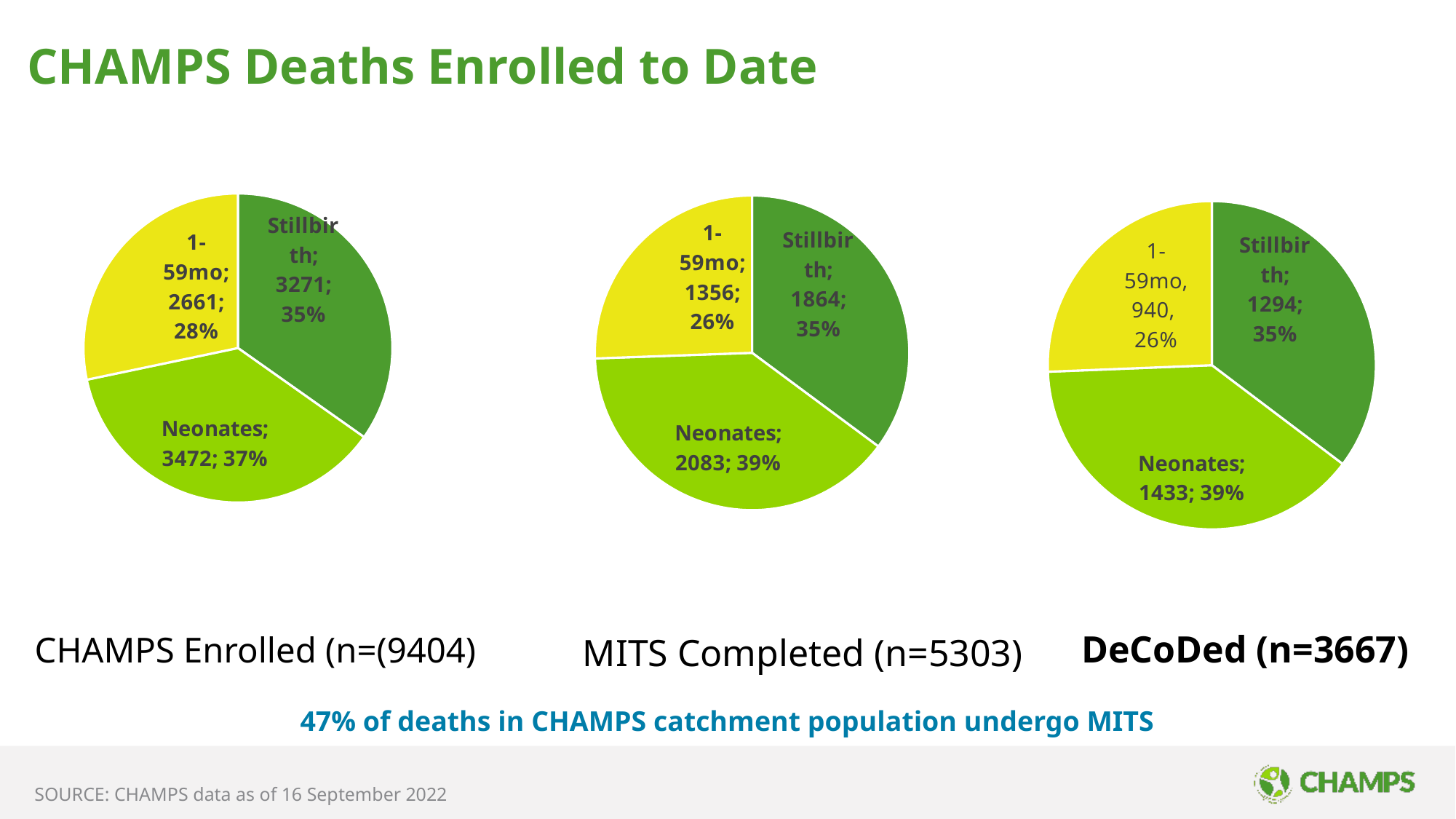
In the MITS Completed pie chart, what percentage share do Neonates have? 39% In the MITS Completed pie chart, what is the difference between the Stillbirth value and the 1-59mo value? 508 In the CHAMPS Enrolled pie chart, which is larger: Stillbirth or 1-59mo? Stillbirth In the CHAMPS Enrolled pie chart, what percentage share does 1-59mo have? 28% In the DeCoDed pie chart, what is the difference between the Neonates value and the Stillbirth value? 139 In the CHAMPS Enrolled pie chart, how many stillbirths are shown? 3271 In the MITS Completed pie chart, which category has the smallest slice? 1-59mo How many slices does the MITS Completed pie chart have? 3 In the CHAMPS Enrolled pie chart, which category has the largest slice? Neonates How many pie charts are shown on the slide? 3 In the DeCoDed pie chart, what is the value for 1-59mo? 940 What type of chart is used for the DeCoDed data? Pie chart